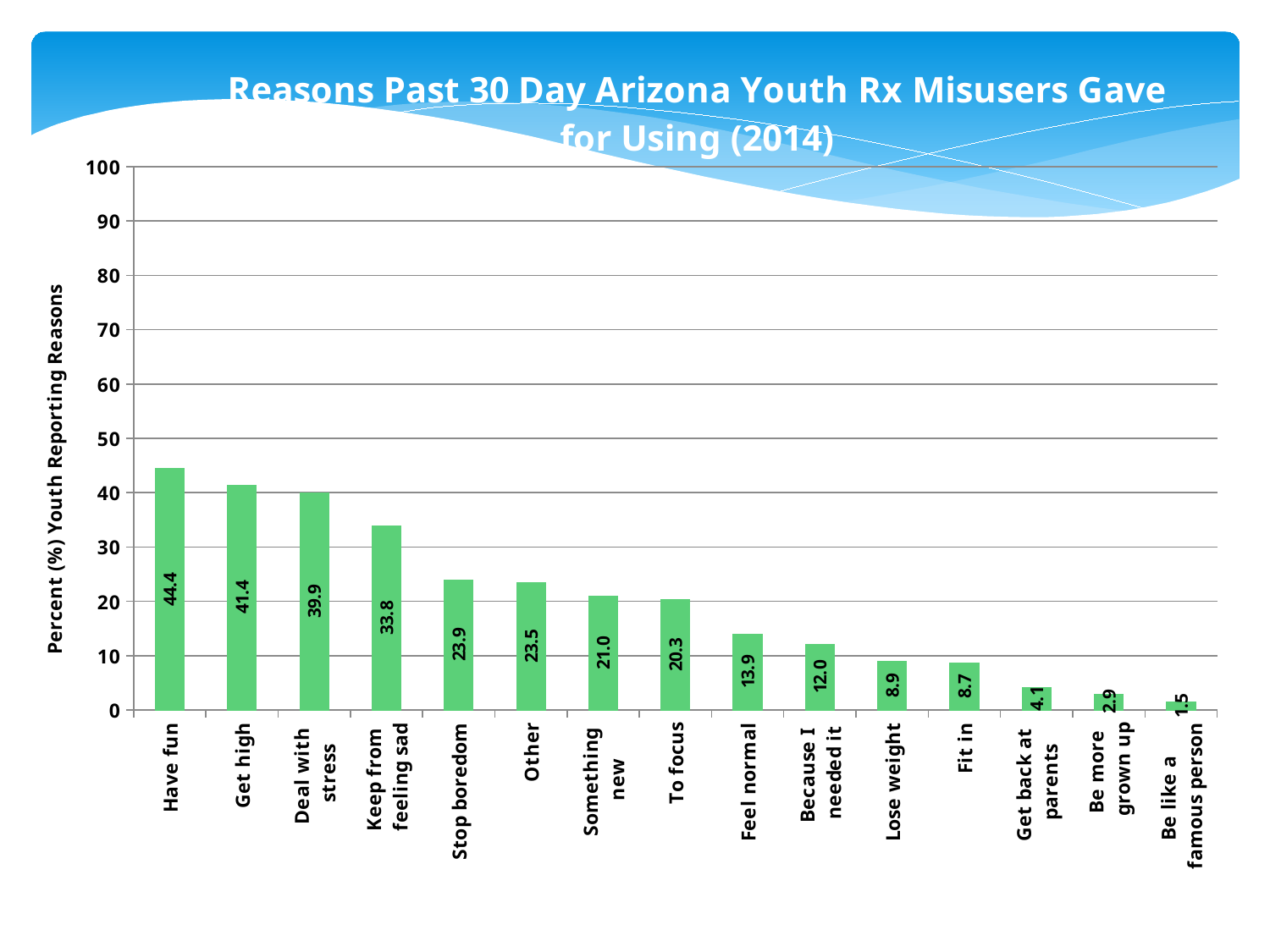
Which reason has the lowest percentage? Be like a famous person What is the difference between the values for "Get high" and "Deal with stress"? 1.5 Which reason has the highest percentage? Have fun What percent of youth reported "Have fun" as a reason? 44.4 What is the value for "Lose weight"? 8.9 What is the label of the vertical axis? Percent (%) Youth Reporting Reasons What kind of chart is shown on the slide? bar chart What is the value for "Keep from feeling sad"? 33.8 Which is larger, the value for "Stop boredom" or the value for "To focus"? Stop boredom Do the values rise or fall moving from left to right along the x axis? fall How many reasons (categories) are shown on the chart? 15 Is the value for "Feel normal" greater or less than 20? less